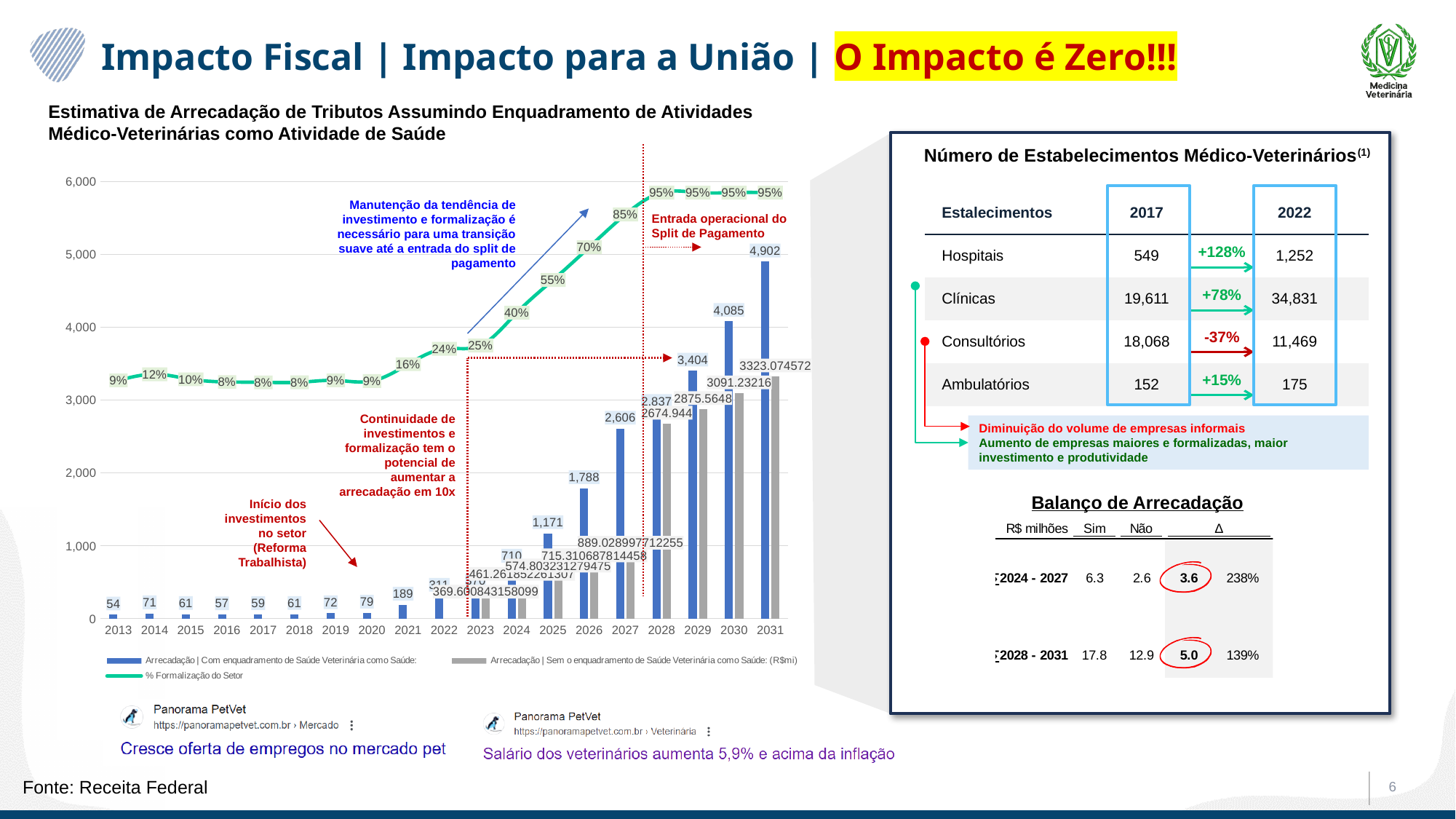
Which year has the lowest blue bar (Arrecadação com enquadramento)? 2013 What is the value of the blue bar (Arrecadação com enquadramento) for 2031? 4,902 How many years are shown on the x axis of the chart? 19 What is the value of the blue bar (Arrecadação com enquadramento) for 2013? 54 What is the value of the gray bar (Sem o enquadramento) for 2031? 3323.074572 What percentage of formalização do setor is shown for 2027? 85% Which year has the highest blue bar (Arrecadação com enquadramento)? 2031 Which is larger, the blue bar for 2026 or the blue bar for 2027? 2027 How many series does the chart legend list? 3 Does the % Formalização do Setor line rise or fall from 2020 to 2028? rise Is the gray bar value for 2029 greater or less than 3,000? less What is the difference between the blue bar values for 2031 and 2030? 817